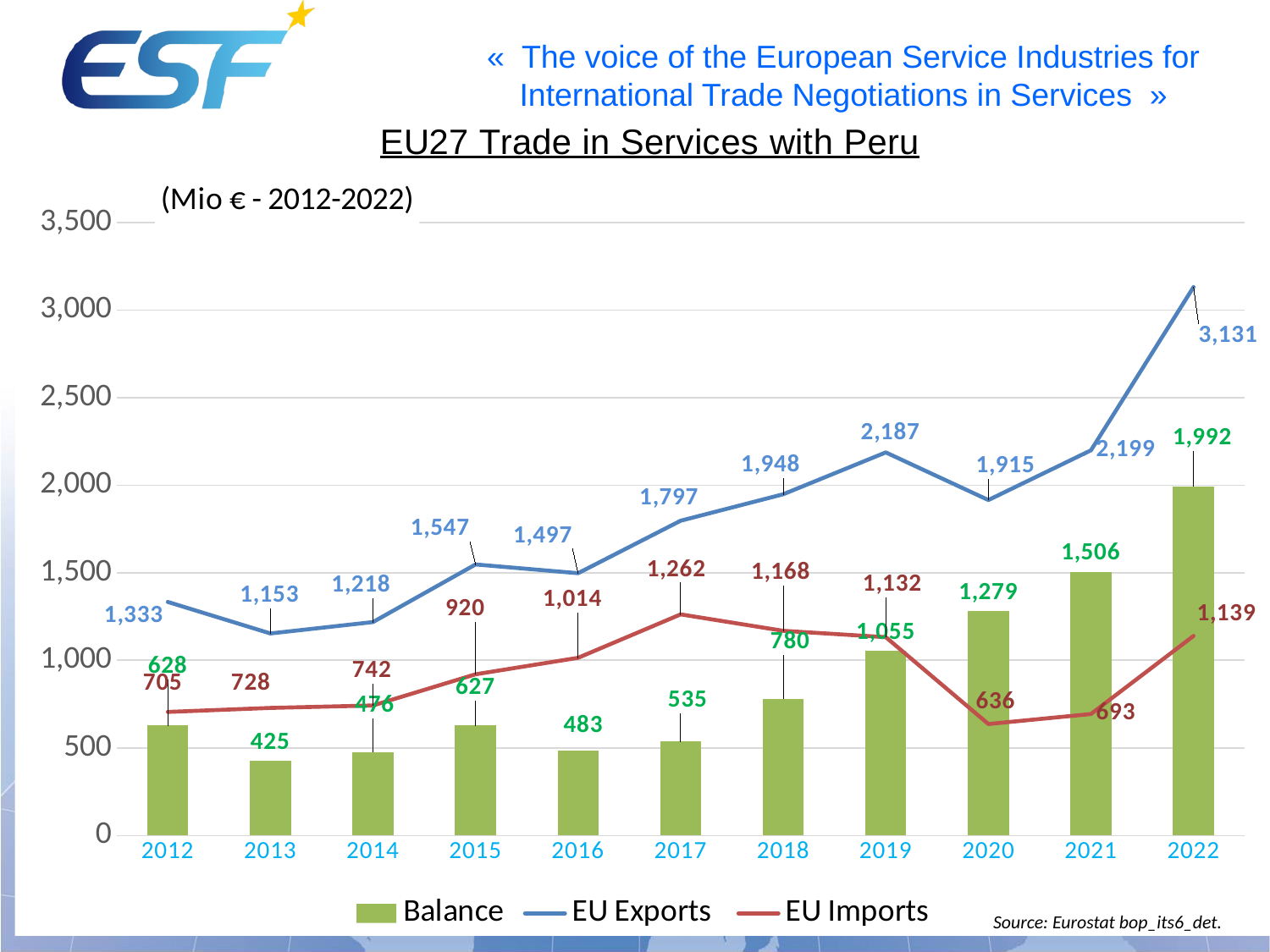
What was the value of EU Exports in 2022? 3,131 Was the value of EU Exports in 2019 greater or less than 2,000? greater What is the difference between EU Exports and EU Imports in 2012? 628 What was the Balance in 2019? 1,055 In which year were EU Imports lowest? 2020 Did the Balance rise or fall from 2018 to 2022? rise In which year was the Balance highest? 2022 How many series does the legend list? 3 Which was larger in 2020: EU Exports or EU Imports? EU Exports How many years are shown on the x axis? 11 What was the value of EU Imports in 2017? 1,262 What is the source cited for the chart? Eurostat bop_its6_det.